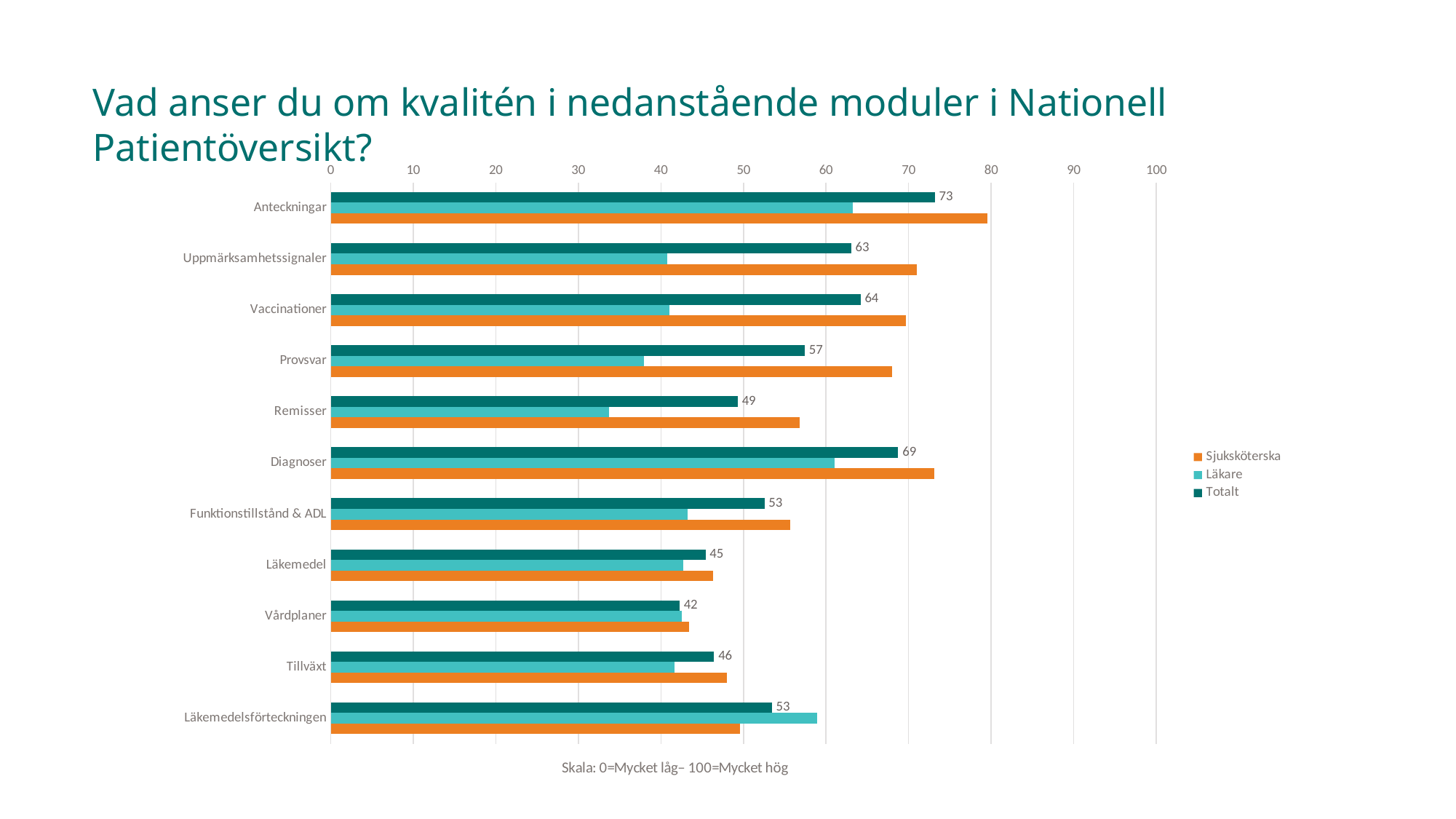
How many series does the legend list? 3 Is the Sjuksköterska value for Anteckningar greater or less than 70? greater What is the difference between the Totalt values for Anteckningar and Vårdplaner? 31 Which has a larger Totalt value, Diagnoser or Remisser? Diagnoser What is the Totalt value for Provsvar? 57 What is the Totalt value for Anteckningar? 73 How many categories (modules) are shown on the chart? 11 What is the Totalt value for Vårdplaner? 42 What kind of chart is shown on the slide? Bar chart Which category has the highest Totalt value? Anteckningar Which category has the lowest Totalt value? Vårdplaner Is the Läkare value for Remisser greater or less than 40? less